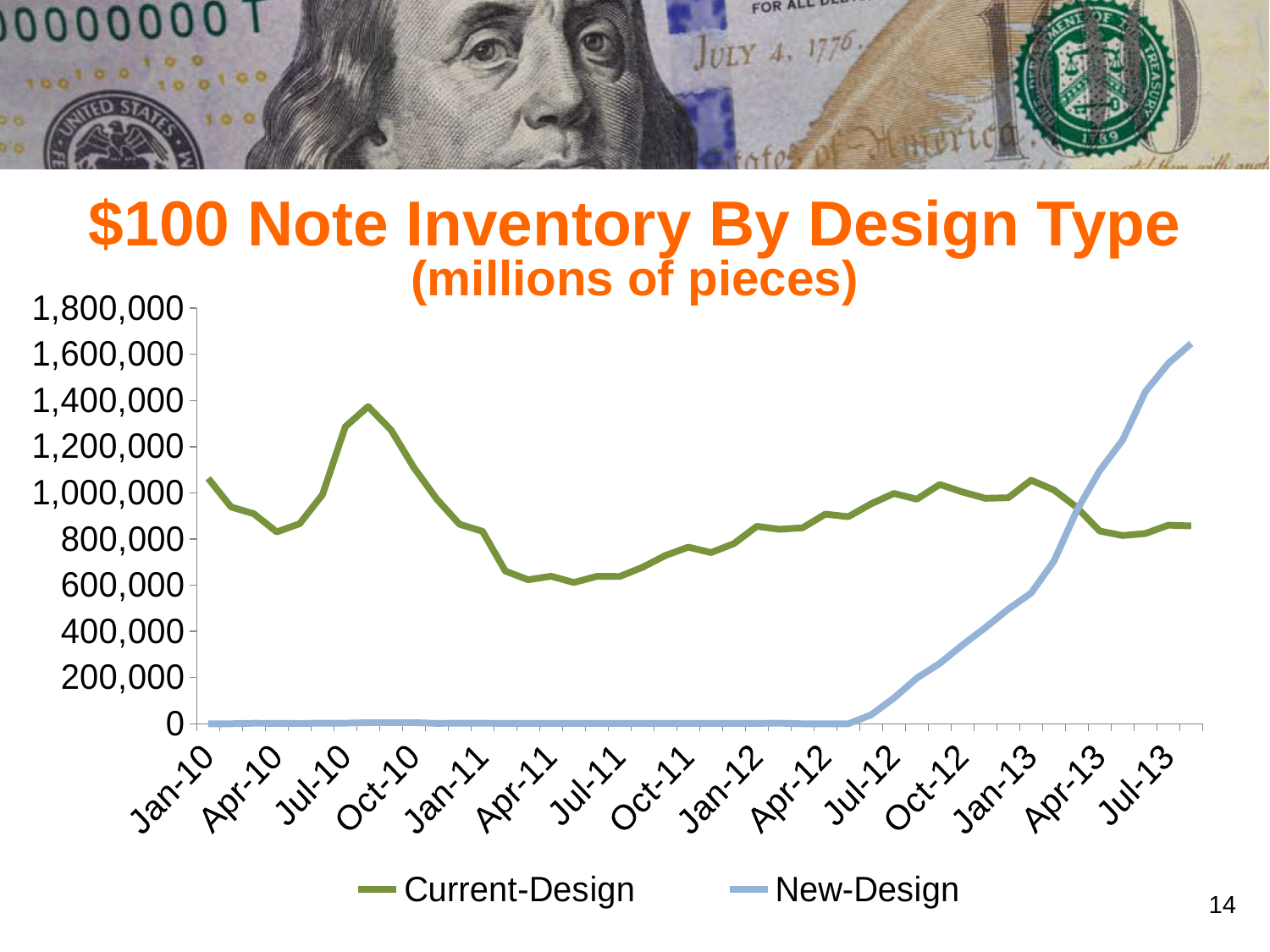
Does the New-Design line rise or fall between Jul-12 and Jul-13? rise What are the two series named in the legend? Current-Design and New-Design Is the value for New-Design at Jul-13 greater or less than 1,400,000? greater At Jan-12, which series has the larger value, Current-Design or New-Design? Current-Design What kind of chart is shown on the slide? line chart Is the value for Current-Design at Jan-10 greater or less than 800,000? greater Is the value for Current-Design at Apr-11 greater or less than 800,000? less What is the title of the chart? $100 Note Inventory By Design Type (millions of pieces) How many series does the legend list? 2 At Jul-13, which series has the larger value, Current-Design or New-Design? New-Design